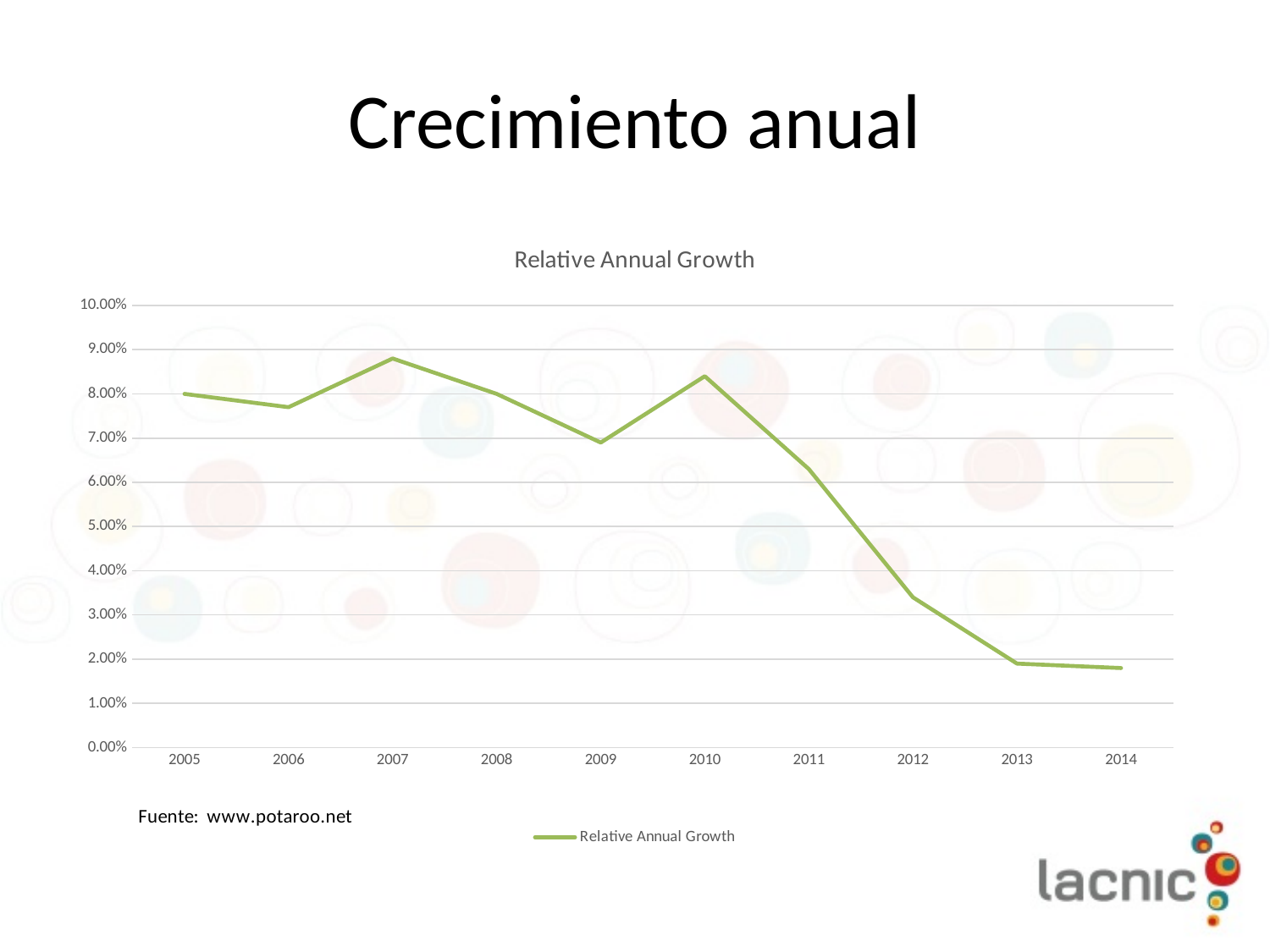
Is the value for 2010 greater or less than 8.00%? greater Is the value for 2014 greater or less than 3.00%? less Is the value for 2012 greater or less than 4.00%? less How many years are plotted on the x axis of the chart? 10 What kind of chart is shown on the slide? line chart Which year has the larger value, 2009 or 2011? 2009 Which year has the larger value, 2007 or 2010? 2007 Which year has the highest relative annual growth? 2007 What is the title of the chart? Relative Annual Growth Overall, does the relative annual growth rise or fall from 2005 to 2014? fall How many series does the chart's legend list? 1